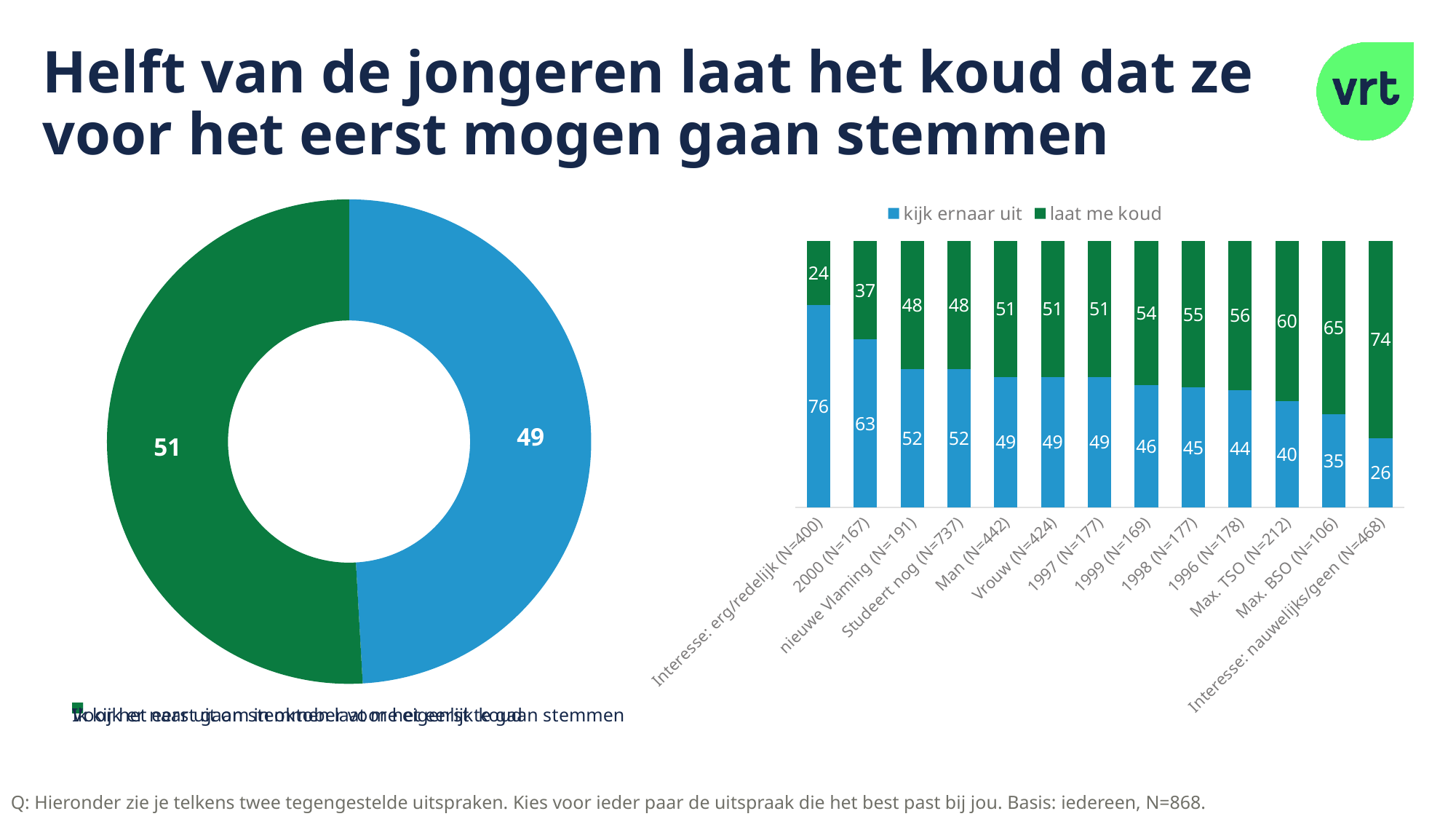
In the stacked bar chart on the right, which category has the highest 'laat me koud' value? Interesse: nauwelijks/geen (N=468) What kind of chart is on the left of the slide? pie chart (donut) How many categories are shown in the stacked bar chart on the right? 13 In the stacked bar chart on the right, what is the total of the stacked bar for Man (N=442)? 100 In the stacked bar chart on the right, which is larger: the 'laat me koud' value for 1999 (N=169) or for 1996 (N=178)? 1996 (N=178) In the stacked bar chart on the right, what is the difference between the 'kijk ernaar uit' values for 2000 (N=167) and Max. TSO (N=212)? 23 In the donut chart on the left, what is the value of the green slice? 51 In the stacked bar chart on the right, what is the 'kijk ernaar uit' value for Interesse: erg/redelijk (N=400)? 76 In the stacked bar chart on the right, does the 'kijk ernaar uit' value rise or fall from left to right across the categories? fall How many series does the legend of the stacked bar chart on the right list? 2 In the stacked bar chart on the right, which category has the lowest 'kijk ernaar uit' value? Interesse: nauwelijks/geen (N=468) In the stacked bar chart on the right, what is the 'laat me koud' value for Max. BSO (N=106)? 65